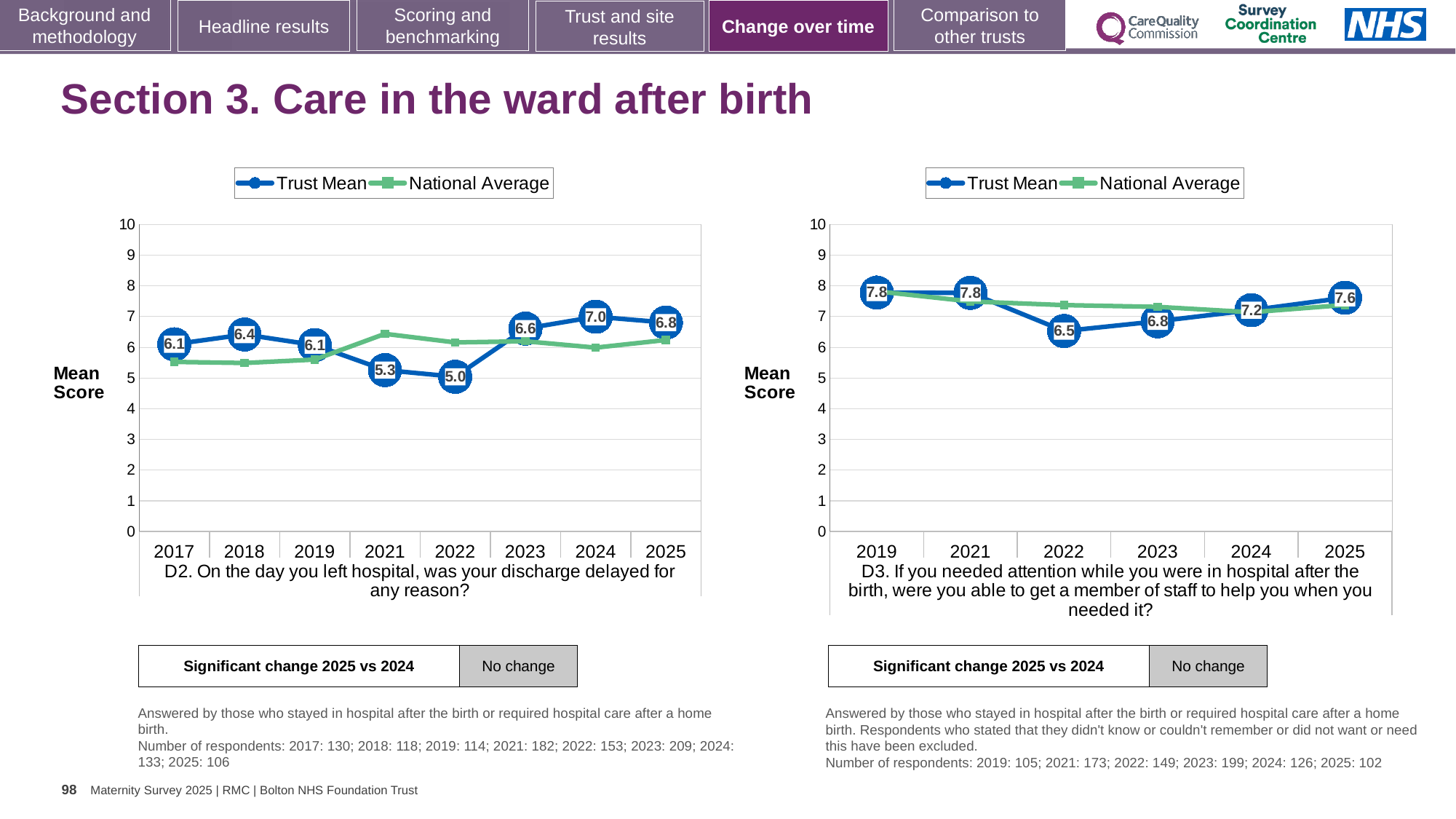
In the right chart (D3, able to get a member of staff), how many series does the legend list? 2 In the right chart (D3, able to get a member of staff), which year has the lowest Trust Mean? 2022 What type of chart is the right chart (D3, able to get a member of staff)? Line chart In the left chart (D2, discharge delayed), what is the Trust Mean for 2024? 7.0 In the left chart (D2, discharge delayed), what is the Trust Mean for 2022? 5.0 In the right chart (D3, able to get a member of staff), is the Trust Mean for 2025 larger or smaller than the Trust Mean for 2024? larger In the right chart (D3, able to get a member of staff), what is the Trust Mean for 2022? 6.5 In the left chart (D2, discharge delayed), which year has the lowest Trust Mean? 2022 In the left chart (D2, discharge delayed), how many years are shown on the x axis? 8 In the left chart (D2, discharge delayed), is the National Average for 2021 greater or less than 6? greater In the left chart (D2, discharge delayed), what is the difference between the Trust Mean in 2024 and in 2022? 2.0 In the left chart (D2, discharge delayed), which year has the highest Trust Mean? 2024